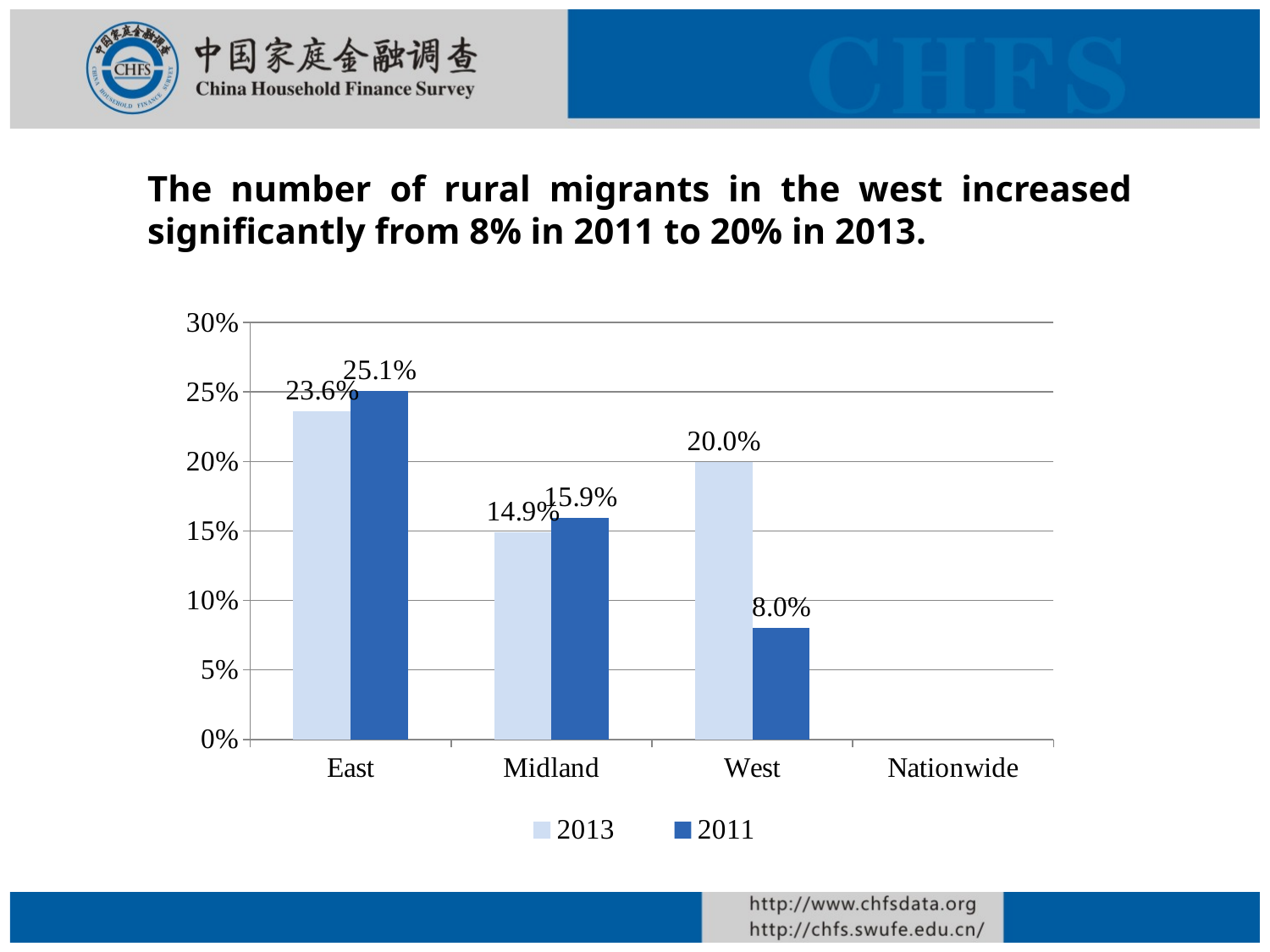
What is the value for West in the 2011 series? 8.0% Which series is shown in the darker blue colour in the legend? 2011 Which is larger for Midland, the 2013 value or the 2011 value? 2011 How many series does the legend list? 2 Is the 2013 value for East greater or less than 20%? greater What kind of chart is shown on the slide? Bar chart What is the difference between the 2013 and 2011 values for West? 12.0% What is the value for Midland in the 2013 series? 14.9% Which region has the highest value in the 2011 series? East Which region has the lowest value in the 2011 series? West What is the value for East in the 2011 series? 25.1% What is the value for West in the 2013 series? 20.0%